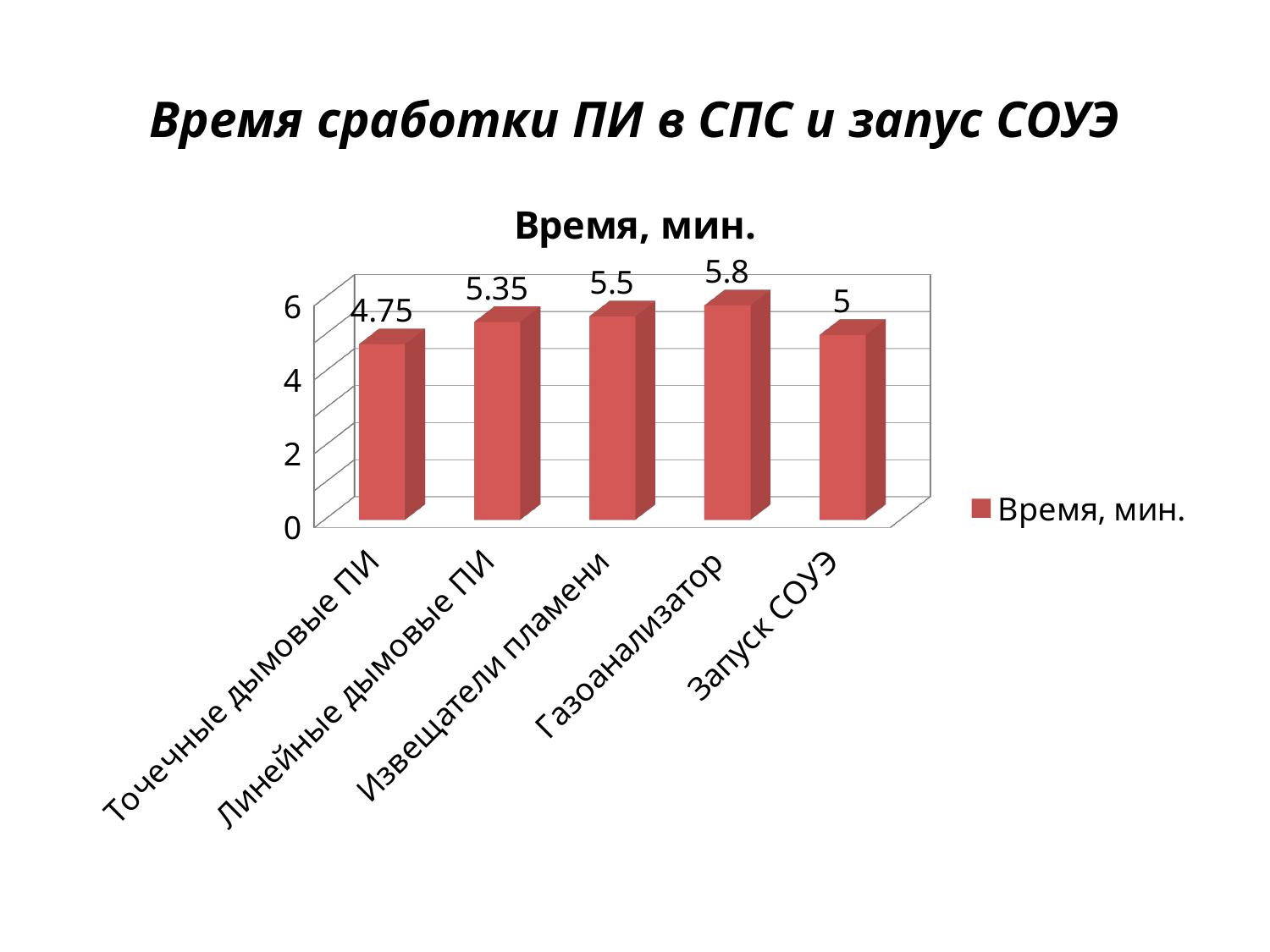
Is the value for Извещатели пламени greater or less than 4? greater What is the difference between the values for Газоанализатор and Точечные дымовые ПИ? 1.05 Which category has the lowest value? Точечные дымовые ПИ Which category has the highest value? Газоанализатор What kind of chart is shown on the slide? bar chart What is the value for Газоанализатор? 5.8 Which is larger, the value for Линейные дымовые ПИ or the value for Запуск СОУЭ? Линейные дымовые ПИ How many categories are shown on the x axis? 5 What is the value for Точечные дымовые ПИ? 4.75 What is the title of the chart? Время, мин. What is the value for Извещатели пламени? 5.5 What is the value for Запуск СОУЭ? 5